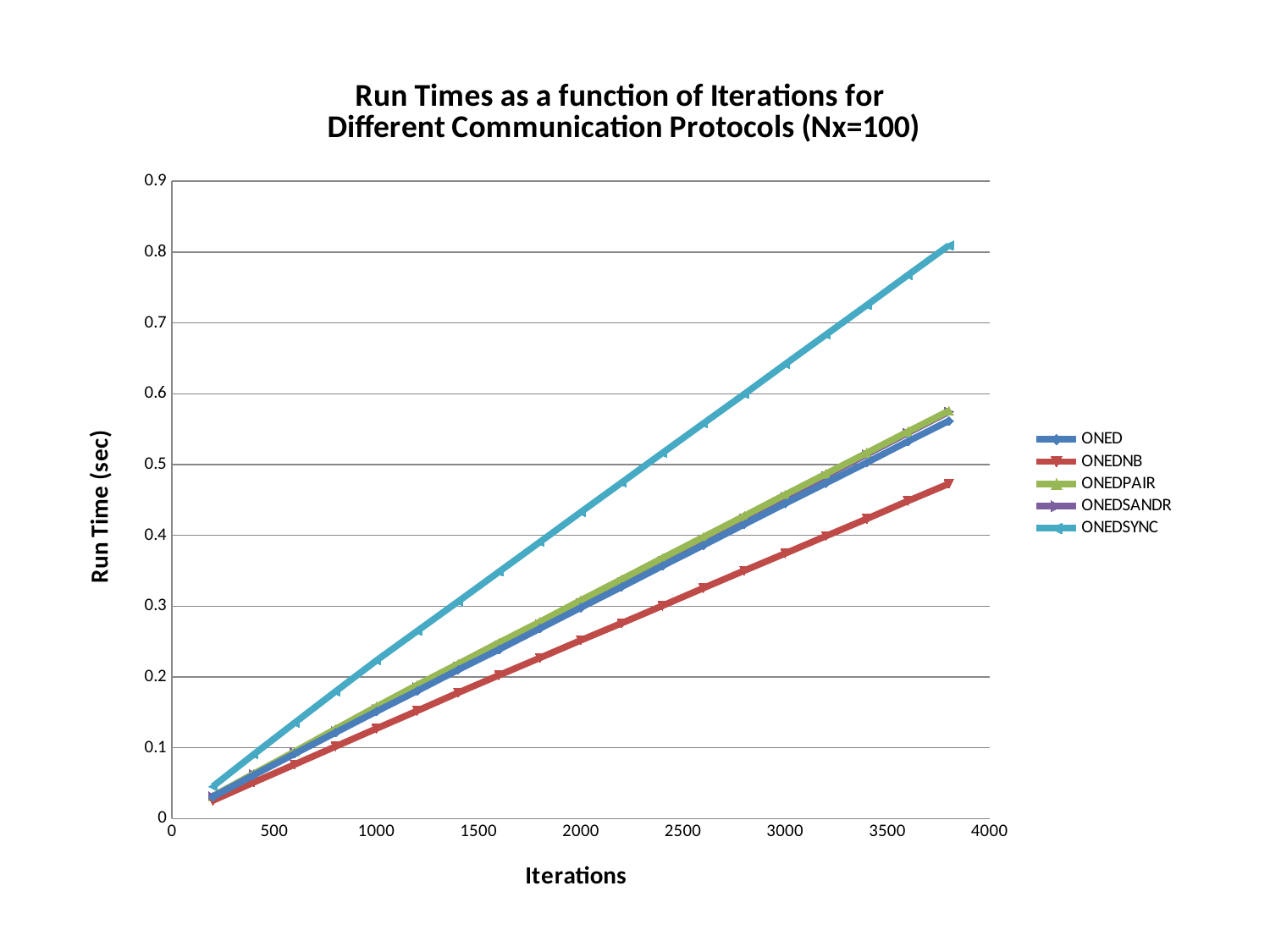
Is the run time for ONEDNB at 1000 iterations greater or less than 0.2? less Do the run times rise or fall as the number of iterations increases? rise At 3000 iterations, which series has the larger run time, ONEDSYNC or ONEDNB? ONEDSYNC Is the run time for ONEDSYNC at 2000 iterations greater or less than 0.4? greater What kind of chart is shown on the slide? line chart Which series has the lowest run time at 3500 iterations? ONEDNB Is the run time for ONEDNB at 3000 iterations greater or less than 0.4? less What is the title of the chart? Run Times as a function of Iterations for Different Communication Protocols (Nx=100) Which series has the highest run time at 3500 iterations? ONEDSYNC How many series does the legend list? 5 What is the label of the y axis? Run Time (sec)